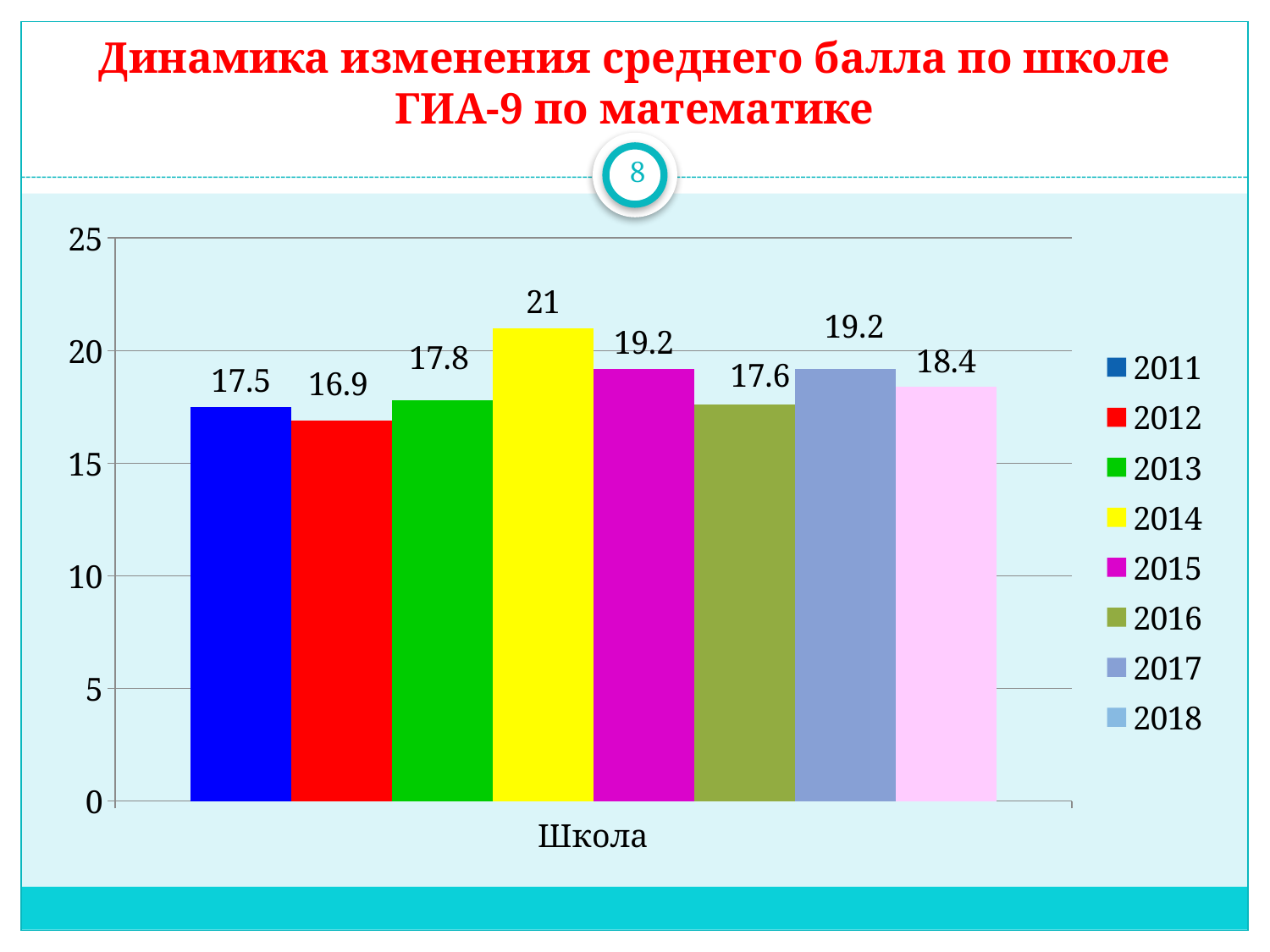
What is the label on the x axis of the chart? Школа Which is larger, the score for 2013 or the score for 2016? 2013 What is the difference between the 2015 score and the 2018 score? 0.8 What is the difference between the 2014 score and the 2012 score? 4.1 What is the average score for 2014? 21 What is the average score for 2012? 16.9 Is the value for 2014 greater or less than 20? greater What is the average score for 2018? 18.4 How many series does the legend list? 8 Which year has the highest average score? 2014 What kind of chart is shown on the slide? bar chart Which year has the lowest average score? 2012